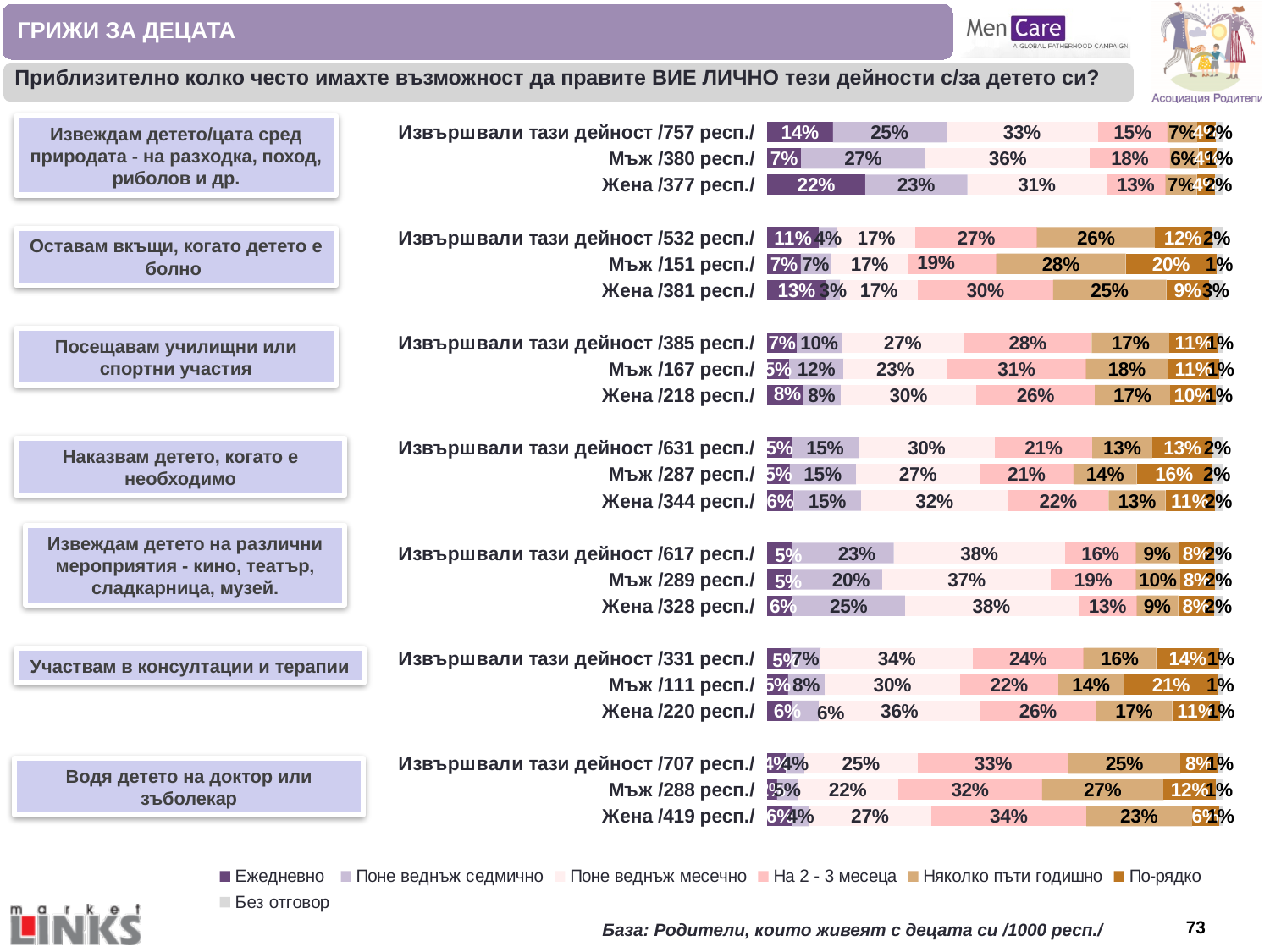
In the chart for "Водя детето на доктор или зъболекар", what is the "На 2 - 3 месеца" share for women (Жена)? 34% In the chart for "Извеждам детето/цата сред природата", what is the "Ежедневно" share for women (Жена)? 22% In the chart for "Оставам вкъщи, когато детето е болно", what is the "По-рядко" share for men (Мъж)? 20% In the chart for "Извеждам детето/цата сред природата", what percentage of all respondents (Извършвали тази дейност) answered "Поне веднъж месечно"? 33% How many response categories does the legend list? 7 In the chart for "Посещавам училищни или спортни участия", what is the "На 2 - 3 месеца" share for men (Мъж)? 31% In the chart for "Наказвам детето, когато е необходимо", what is the difference between the "Поне веднъж месечно" share for women (32%) and for men (27%)? 5% What type of chart is used on this slide? Stacked bar chart In the chart for "Оставам вкъщи, когато детето е болно", which is larger for women (Жена): "На 2 - 3 месеца" or "Няколко пъти годишно"? На 2 - 3 месеца How many respondents are in the base for the "Извеждам детето/цата сред природата" chart (Извършвали тази дейност)? 757 In the chart for "Извеждам детето на различни мероприятия", which response category has the highest share among all respondents (Извършвали тази дейност)? Поне веднъж месечно In the chart for "Участвам в консултации и терапии", what is the "По-рядко" share for men (Мъж)? 21%